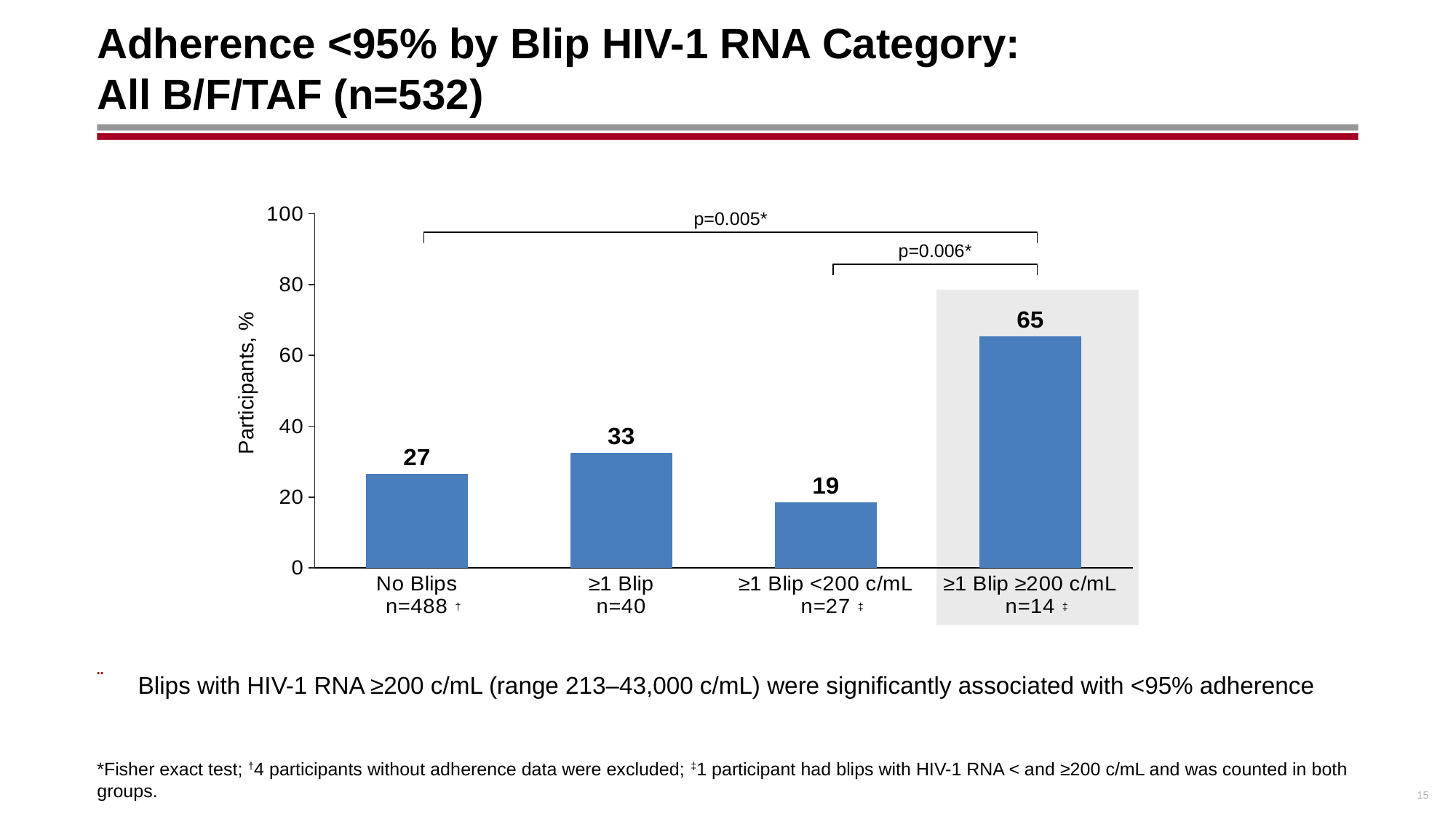
Which category has the lowest percentage of participants? ≥1 Blip <200 c/mL Is the value for ≥1 Blip ≥200 c/mL greater or less than 60? greater What is the value shown for the ≥1 Blip ≥200 c/mL category? 65 Which category has the highest percentage of participants with adherence <95%? ≥1 Blip ≥200 c/mL What is the difference in percentage points between the ≥1 Blip ≥200 c/mL and ≥1 Blip <200 c/mL categories? 46 How many categories are shown on the x axis? 4 What is the label of the y axis? Participants, % What type of chart is shown on the slide? Bar chart Which is larger, the value for ≥1 Blip or the value for No Blips? ≥1 Blip What percentage of participants with No Blips had adherence <95%? 27 What is the value shown for the ≥1 Blip <200 c/mL category? 19 What is the difference between the ≥1 Blip and No Blips values? 6